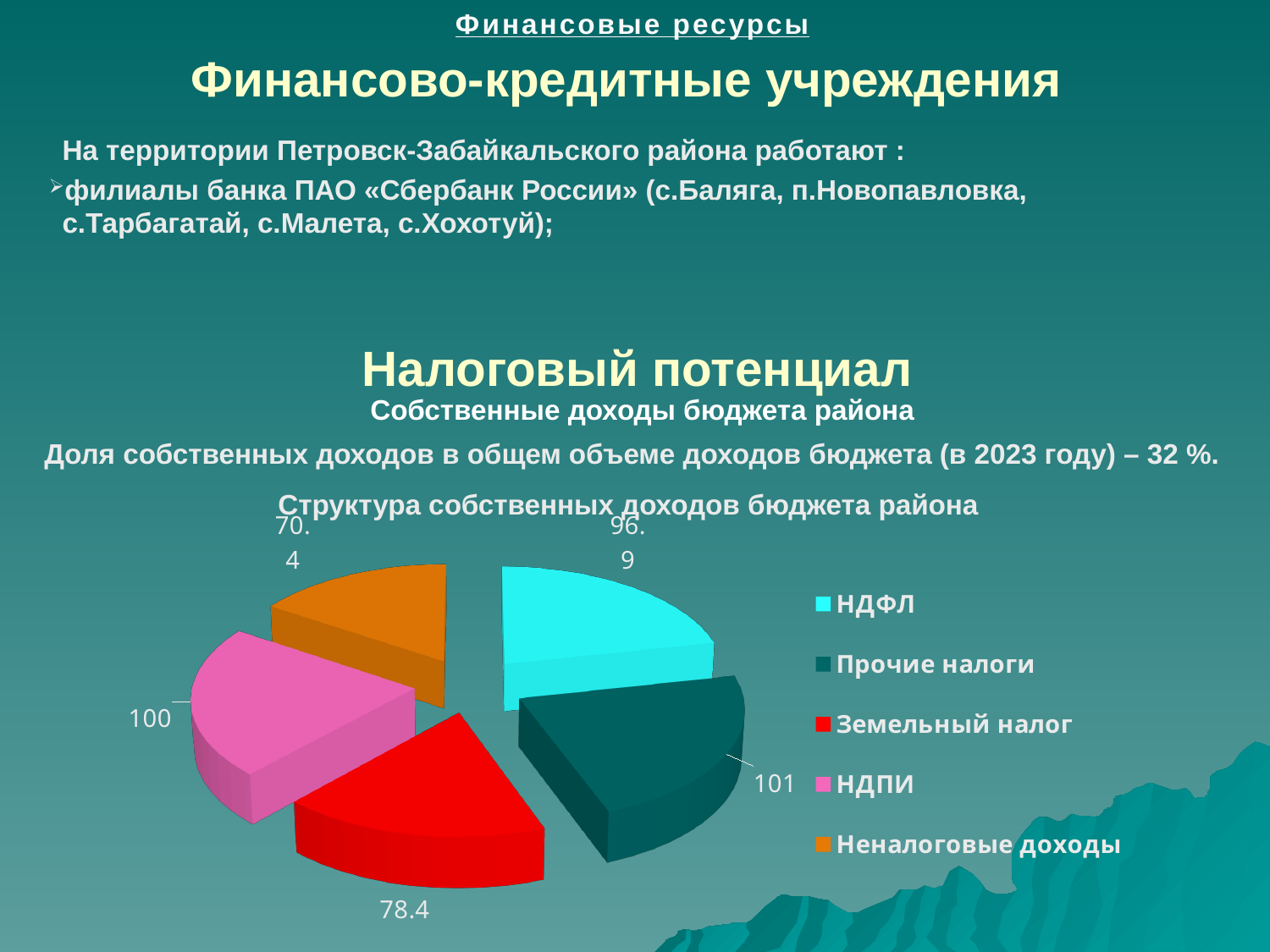
How many categories does the pie chart show? 5 What is the difference between the values for НДПИ and Земельный налог in the pie chart? 21.6 What type of chart is shown under the heading "Структура собственных доходов бюджета района"? Pie chart What is the value shown for Прочие налоги in the pie chart? 101 What is the value shown for НДПИ in the pie chart? 100 What is the value shown for Неналоговые доходы in the pie chart? 70.4 Which category has the smallest value in the pie chart? Неналоговые доходы What is the value shown for Земельный налог in the pie chart? 78.4 What is the value shown for НДФЛ in the pie chart? 96.9 What colour is the slice for Земельный налог in the pie chart? Red Which is larger in the pie chart: the value for НДПИ or the value for Земельный налог? НДПИ Which category has the largest value in the pie chart? Прочие налоги